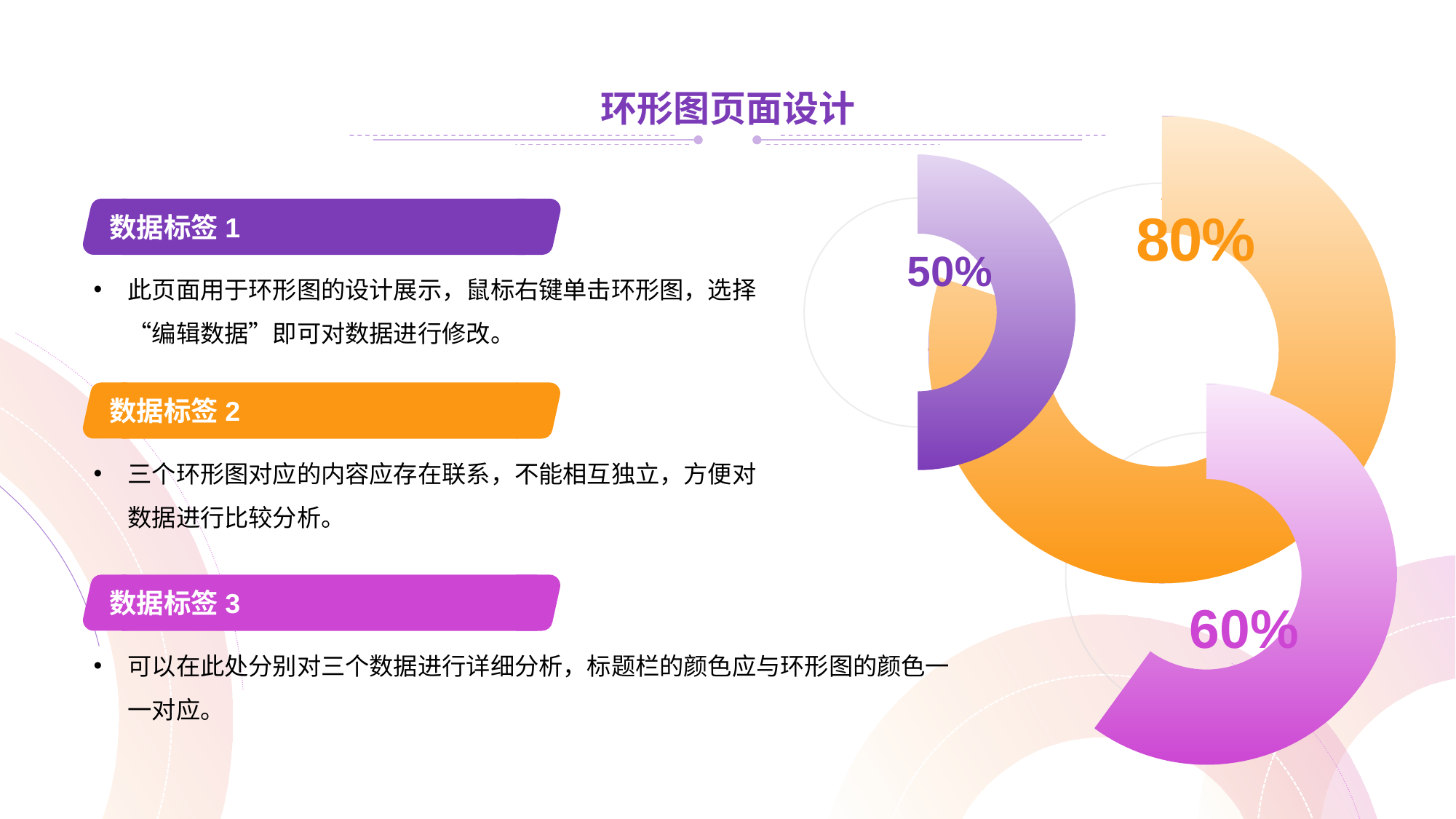
What value is shown on the purple ring chart? 50% What value is shown on the magenta ring chart at the bottom right? 60% Which colour is the ring chart that shows 80%? Orange Which is larger, the value on the magenta ring chart or the value on the purple ring chart? The magenta ring (60%) Which of the three ring charts shows the highest value? The orange ring (80%) Which of the three ring charts shows the lowest value? The purple ring (50%) How many ring charts are shown on the slide? 3 What kind of chart is used on the slide? Ring (donut) chart What is the difference between the value on the orange ring chart and the value on the magenta ring chart? 20% What value is shown on the orange ring chart? 80% What is the difference between the value on the orange ring chart and the value on the purple ring chart? 30% What is the title of the slide? 环形图页面设计